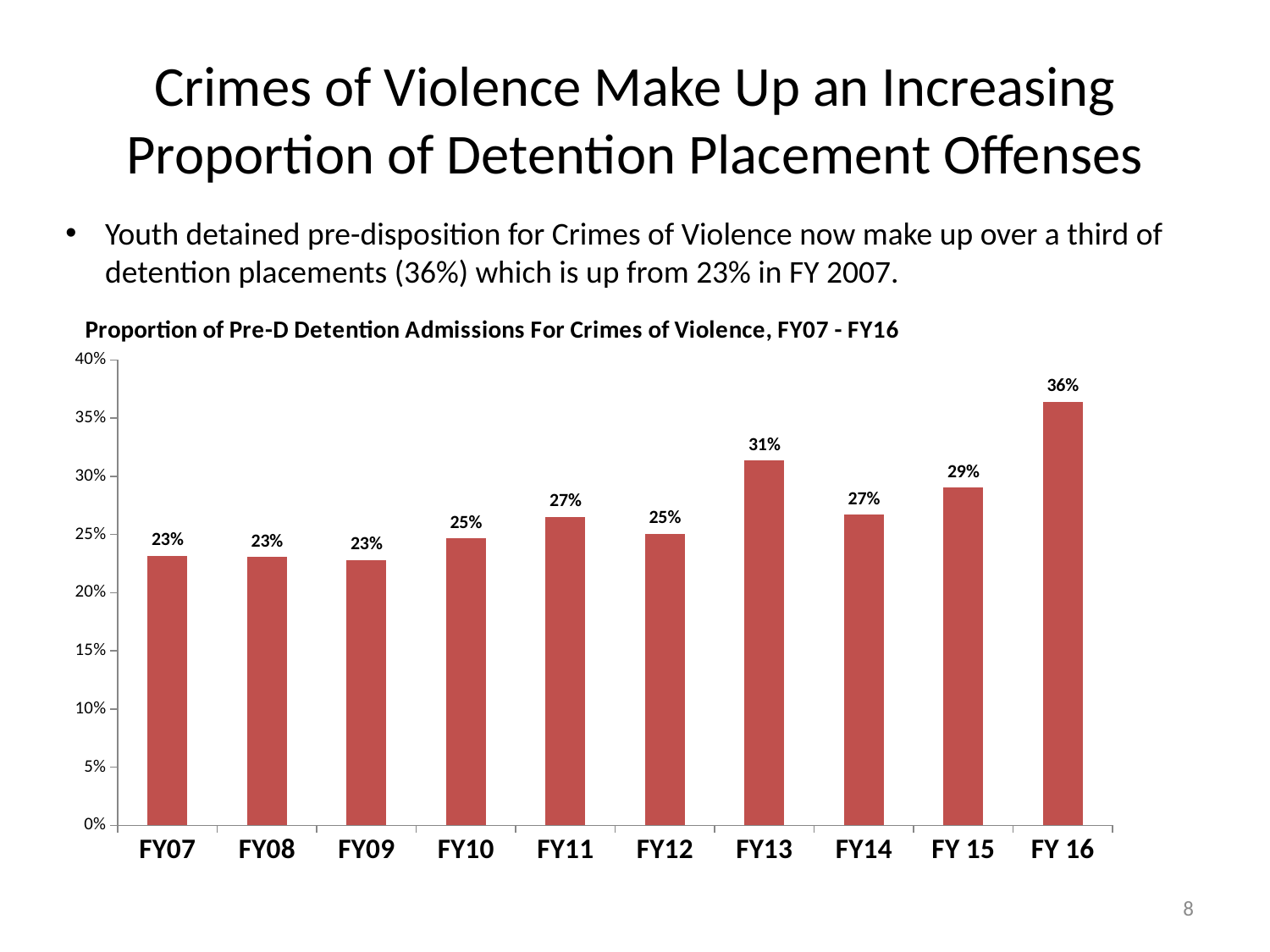
How many fiscal years are shown on the x axis? 10 What is the difference between the FY 16 value and the FY07 value? 13% What is the value for FY 15? 29% What is the title of the chart? Proportion of Pre-D Detention Admissions For Crimes of Violence, FY07 - FY16 Is the value for FY09 greater or less than 25%? less Overall, do the values rise or fall from FY07 to FY 16? rise Which is larger, the value for FY13 or the value for FY14? FY13 What is the value for FY10? 25% Which fiscal year has the highest proportion? FY 16 Is the value for FY 16 greater or less than 35%? greater What kind of chart is shown on the slide? bar chart What is the value for FY13? 31%